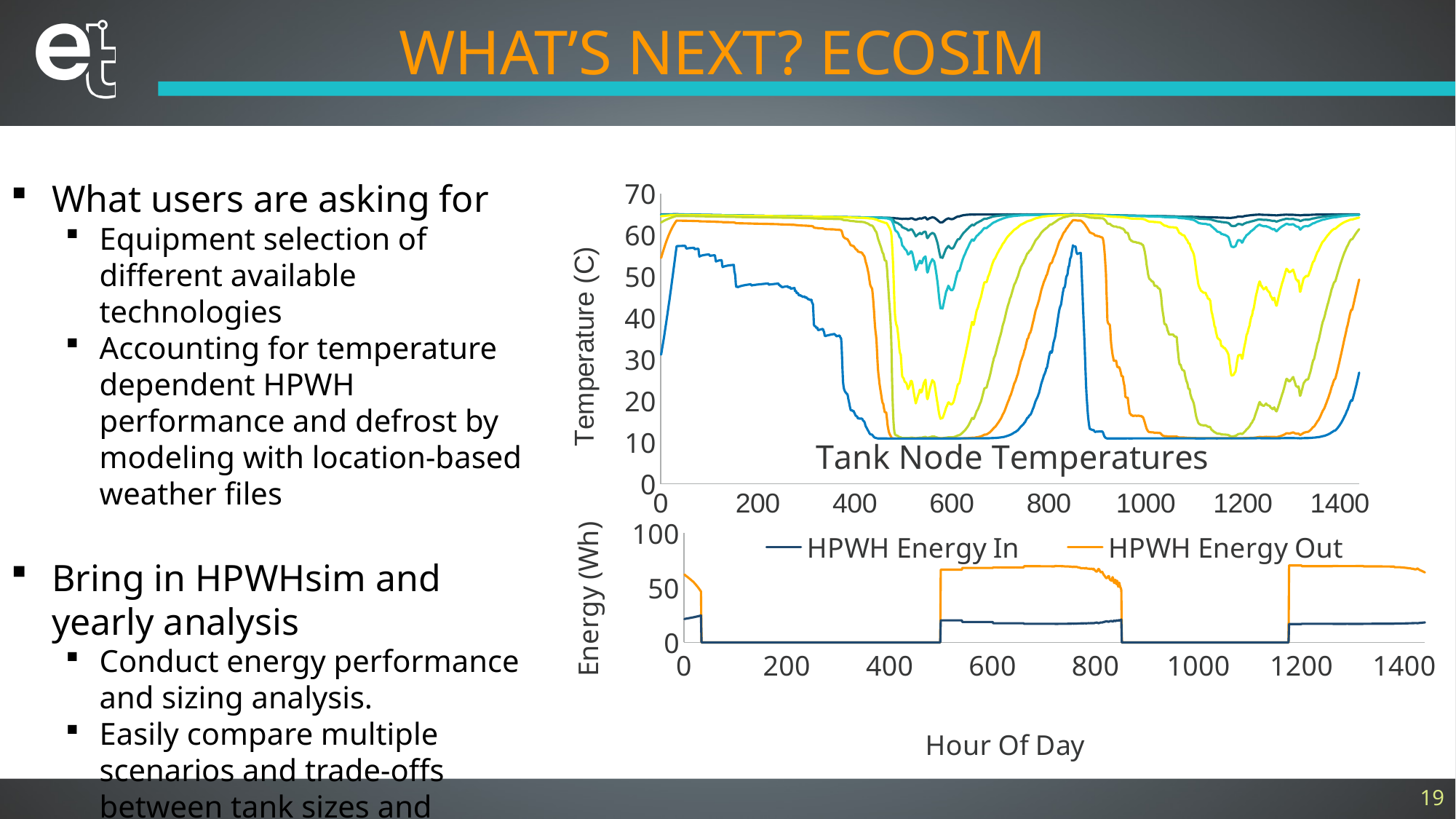
In the bottom Energy (Wh) chart, is the value of HPWH Energy In at hour 300 greater or less than 50? less What kind of chart is the bottom Energy (Wh) chart? line chart In the bottom Energy (Wh) chart, which series is higher at hour 700, HPWH Energy In or HPWH Energy Out? HPWH Energy Out What are the two series named in the legend of the bottom Energy (Wh) chart? HPWH Energy In and HPWH Energy Out How many series does the legend of the bottom Energy (Wh) chart list? 2 In the Tank Node Temperatures chart, is the lowest temperature reached by any line greater or less than 20? less In the bottom Energy (Wh) chart, is the value of HPWH Energy In at hour 600 greater or less than 50? less What is the x-axis label shown below the bottom Energy (Wh) chart? Hour Of Day What kind of chart is the Tank Node Temperatures chart? line chart